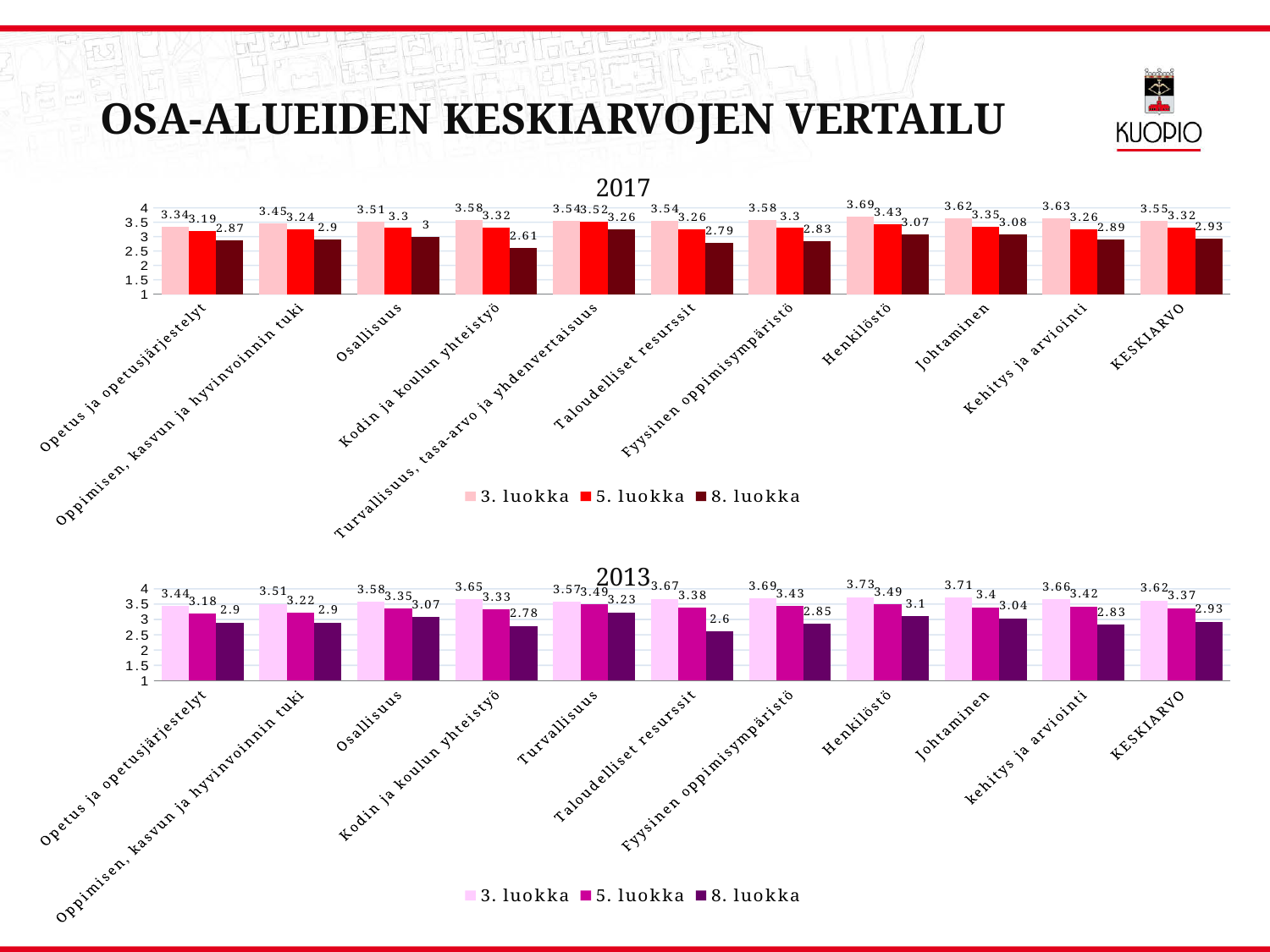
What type of chart is the 2017 chart? Bar chart What are the legend entries of the 2013 chart? 3. luokka, 5. luokka, 8. luokka In the 2017 chart, what is the difference between the 3. luokka and 8. luokka values for KESKIARVO? 0.62 In the 2013 chart, what is the value for 3. luokka in the category Henkilöstö? 3.73 How many series does the legend of the 2013 chart list? 3 How many categories are shown on the x axis of the 2017 chart? 11 In the 2017 chart, which category has the highest value for 3. luokka? Henkilöstö In the 2013 chart, what is the difference between the 5. luokka and 8. luokka values for Taloudelliset resurssit? 0.78 In the 2017 chart, which is larger for Johtaminen: the 5. luokka value or the 8. luokka value? 5. luokka In the 2013 chart, which category has the lowest value for 8. luokka? Taloudelliset resurssit In the 2017 chart, what is the value for 8. luokka in the category Kodin ja koulun yhteistyö? 2.61 In the 2013 chart, is the 8. luokka value for Osallisuus greater or less than 3? greater